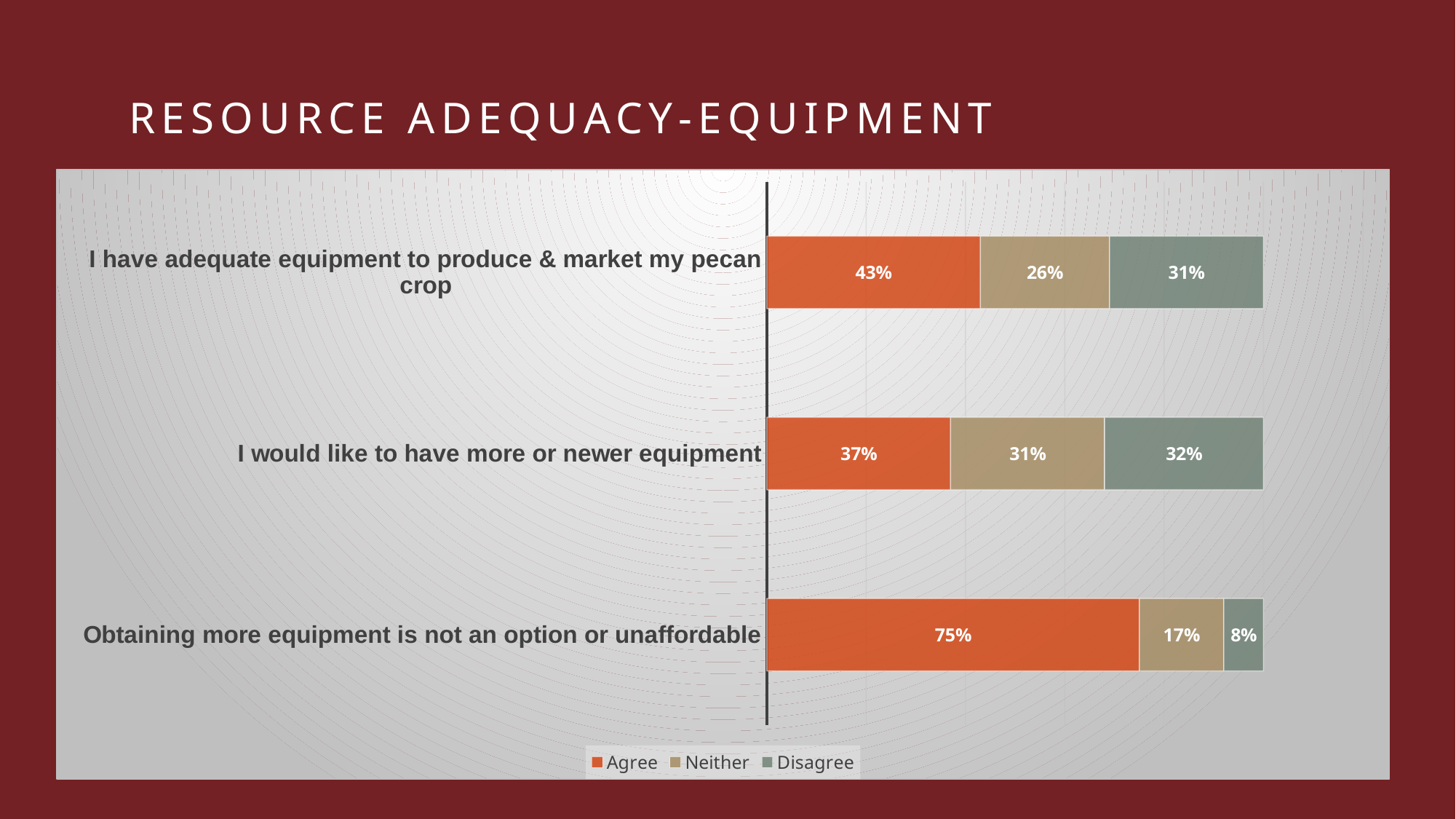
What is the total of the stacked bar for "I have adequate equipment to produce & market my pecan crop"? 100% What kind of chart is shown on the slide? Stacked bar chart Which is larger: the Neither value for "I would like to have more or newer equipment" or the Neither value for "I have adequate equipment to produce & market my pecan crop"? I would like to have more or newer equipment Which statement has the lowest Disagree percentage? Obtaining more equipment is not an option or unaffordable What percentage disagree with "I would like to have more or newer equipment"? 32% What are the three legend entries in the chart? Agree, Neither, Disagree How many series does the legend list? 3 Which statement has the highest Agree percentage? Obtaining more equipment is not an option or unaffordable What percentage agree with "I have adequate equipment to produce & market my pecan crop"? 43% What is the difference between the Agree percentages for "Obtaining more equipment is not an option or unaffordable" and "I would like to have more or newer equipment"? 38% What is the Neither value for "Obtaining more equipment is not an option or unaffordable"? 17% How many statements are shown in the chart? 3